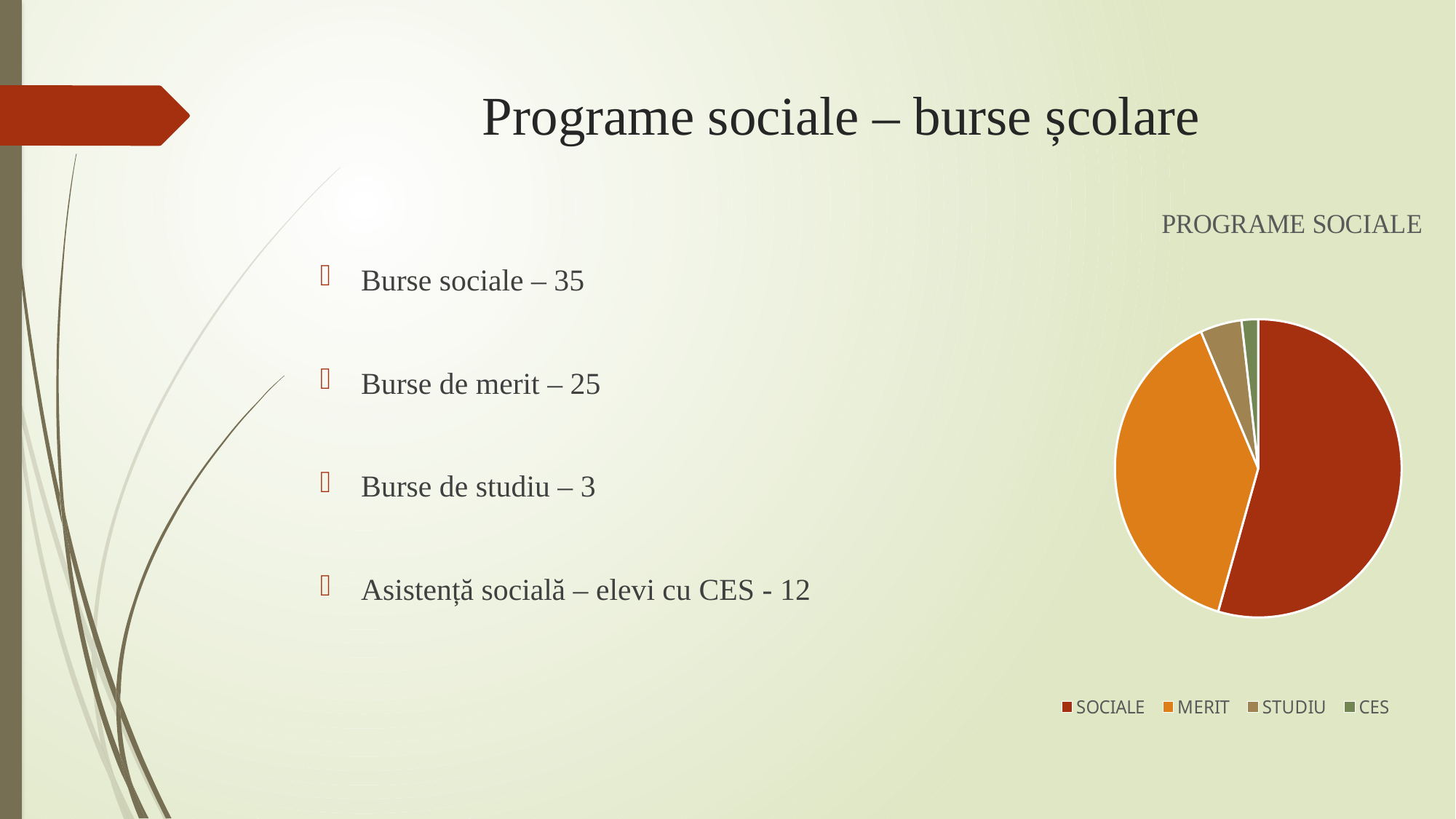
What is the title of the chart? PROGRAME SOCIALE How many slices does the pie chart have? 4 Which slice is larger, SOCIALE or MERIT? SOCIALE What kind of chart is shown on the slide? pie chart How many entries does the chart legend list? 4 Which category has the largest slice in the pie chart? SOCIALE Which slice is larger, MERIT or STUDIU? MERIT Which category has the smallest slice in the pie chart? CES What colour is the SOCIALE slice in the pie chart? dark red Which slice is larger, MERIT or CES? MERIT